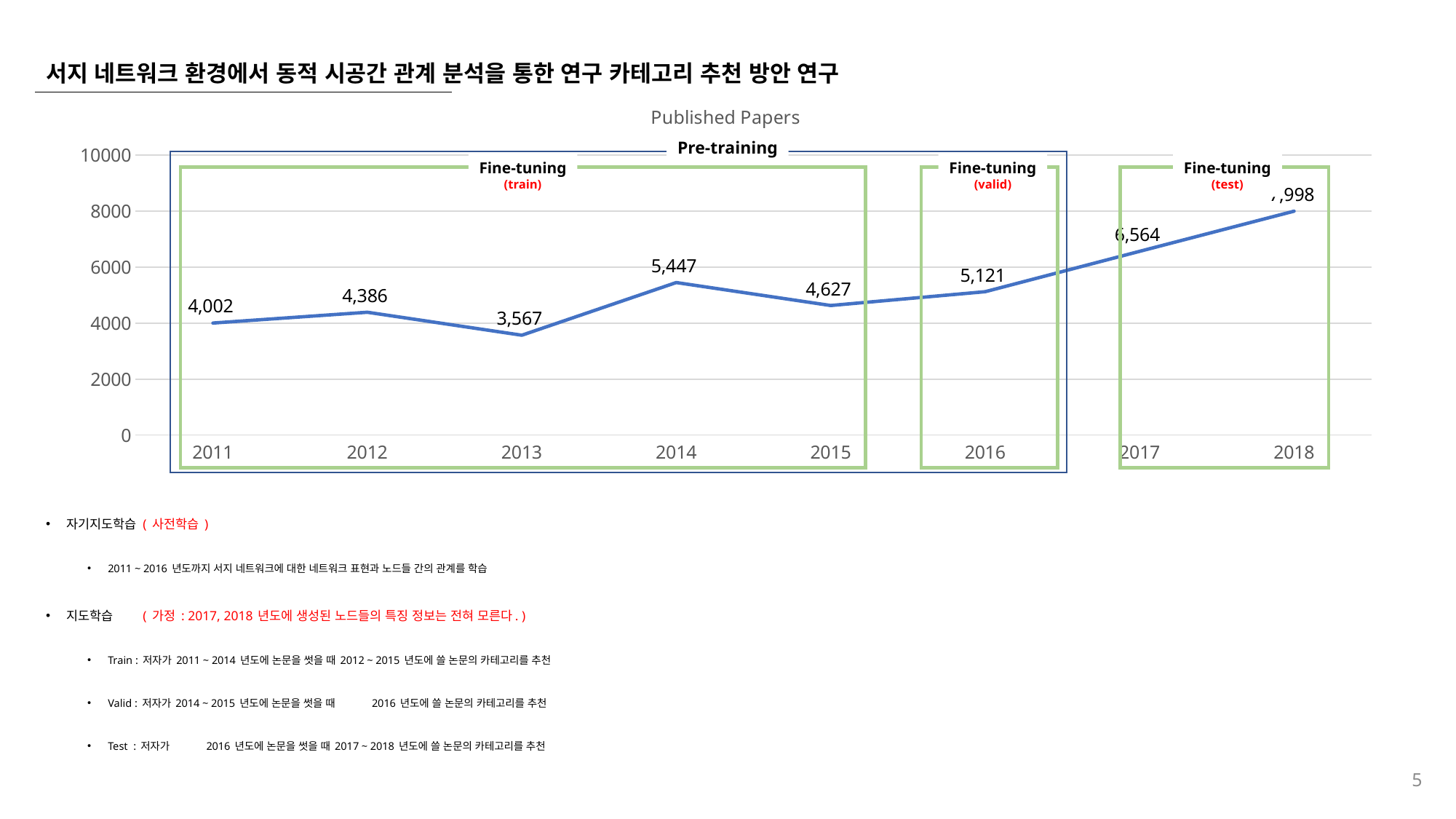
Is the value for 2013 in the Published Papers chart greater or less than 4000? less Does the value in the Published Papers chart rise or fall from 2014 to 2015? fall Which is larger in the Published Papers chart, the value for 2014 or the value for 2016? 2014 How many years are plotted in the Published Papers chart? 8 Is the value for 2018 in the Published Papers chart greater or less than 6000? greater What is the value for 2016 in the Published Papers chart? 5,121 Which year has the highest value in the Published Papers chart? 2018 What is the value for 2014 in the Published Papers chart? 5,447 What is the value for 2011 in the Published Papers chart? 4,002 What is the difference between the values for 2014 and 2013 in the Published Papers chart? 1,880 What kind of chart is the Published Papers chart? line chart Which year has the lowest value in the Published Papers chart? 2013